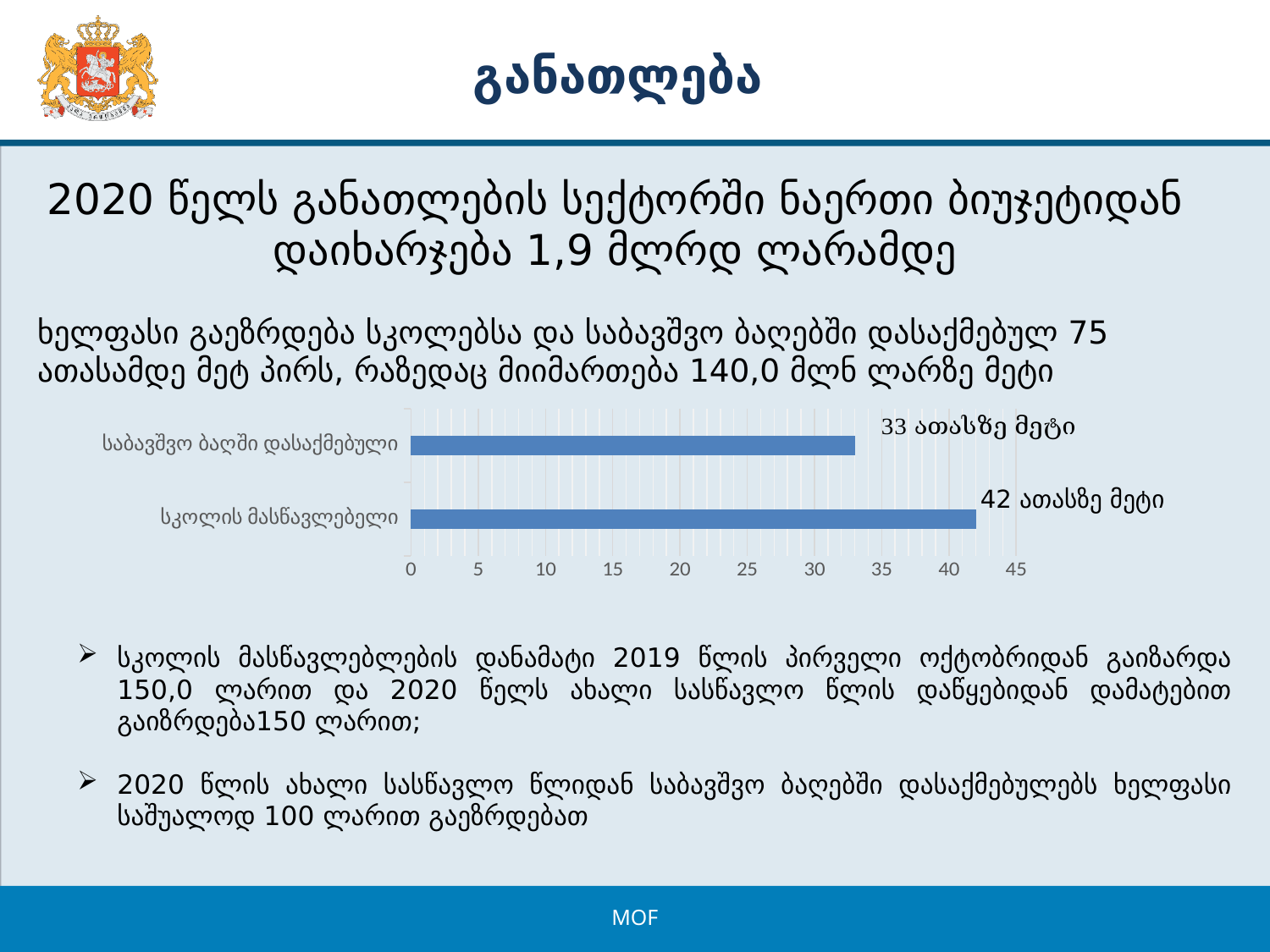
What is the data label shown for the bar "საბავშვო ბაღში დასაქმებული"? 33 ათასზე მეტი How many categories does the bar chart show? 2 What colour are the bars in the chart? blue Which is larger: the value for "სკოლის მასწავლებელი" or the value for "საბავშვო ბაღში დასაქმებული"? სკოლის მასწავლებელი Which category has the longest bar in the chart? სკოლის მასწავლებელი Which category has the shortest bar in the chart? საბავშვო ბაღში დასაქმებული What is the data label shown for the bar "სკოლის მასწავლებელი"? 42 ათასზე მეტი Is the value for "საბავშვო ბაღში დასაქმებული" greater or less than 35? less What is the maximum value shown on the chart's horizontal axis? 45 By how much does the value for "სკოლის მასწავლებელი" (42) exceed the value for "საბავშვო ბაღში დასაქმებული" (33)? 9 What kind of chart is shown on the slide? bar chart Is the value for "სკოლის მასწავლებელი" greater or less than 40? greater